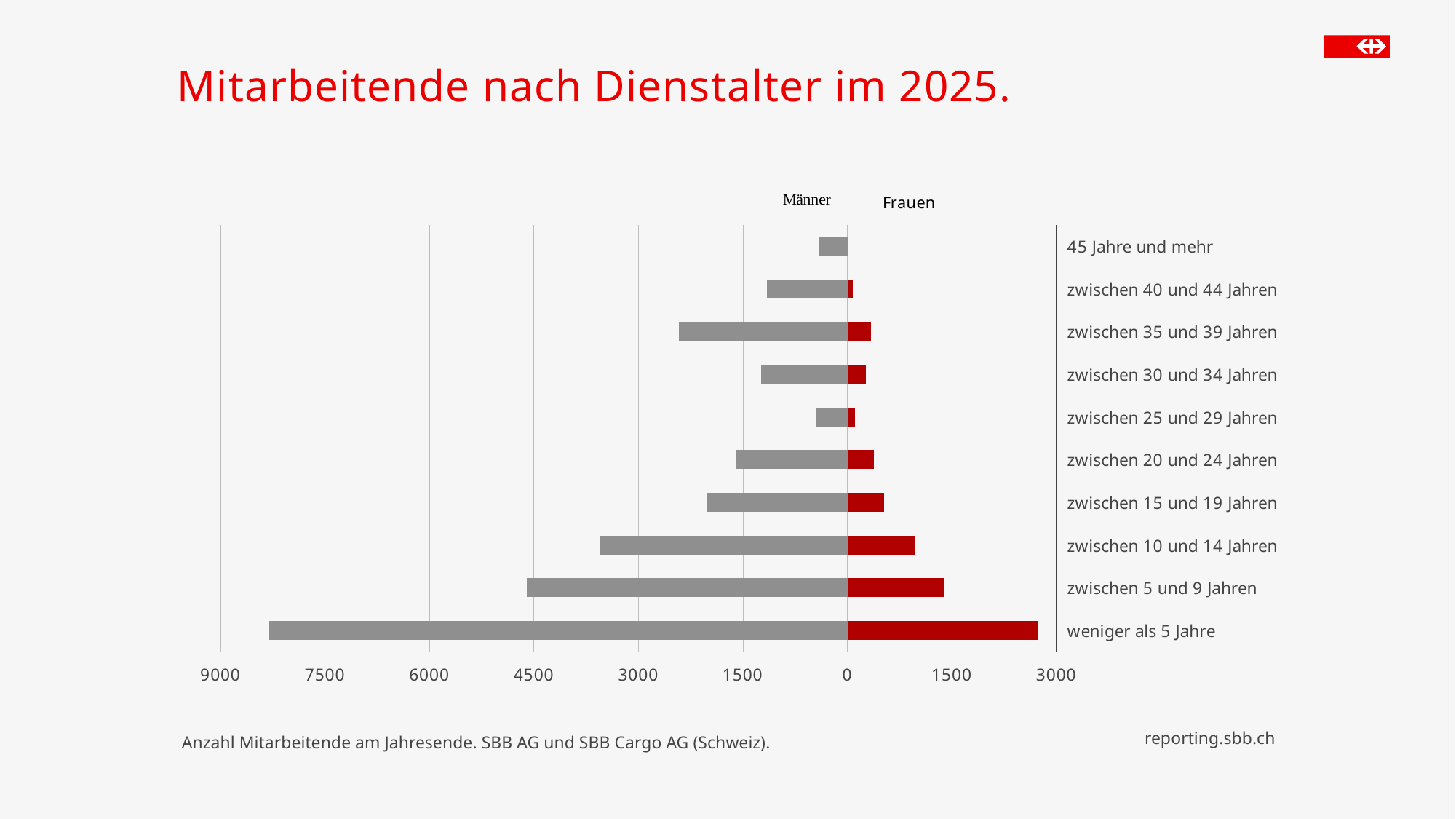
Is the Männer value for 'zwischen 25 und 29 Jahren' greater or less than 1500? less Is the Männer value for 'zwischen 10 und 14 Jahren' greater or less than 3000? greater Is the Frauen value for 'weniger als 5 Jahre' greater or less than 3000? less What kind of chart is shown on the slide? bar chart How many service-age categories are shown in the chart? 10 What is the title of the chart? Mitarbeitende nach Dienstalter im 2025. Which colour represents Frauen in the chart? red For Männer, which is larger: 'zwischen 35 und 39 Jahren' or 'zwischen 30 und 34 Jahren'? zwischen 35 und 39 Jahren Which category has the highest value for Frauen? weniger als 5 Jahre Which category has the highest value for Männer? weniger als 5 Jahre How many series does the chart show? 2